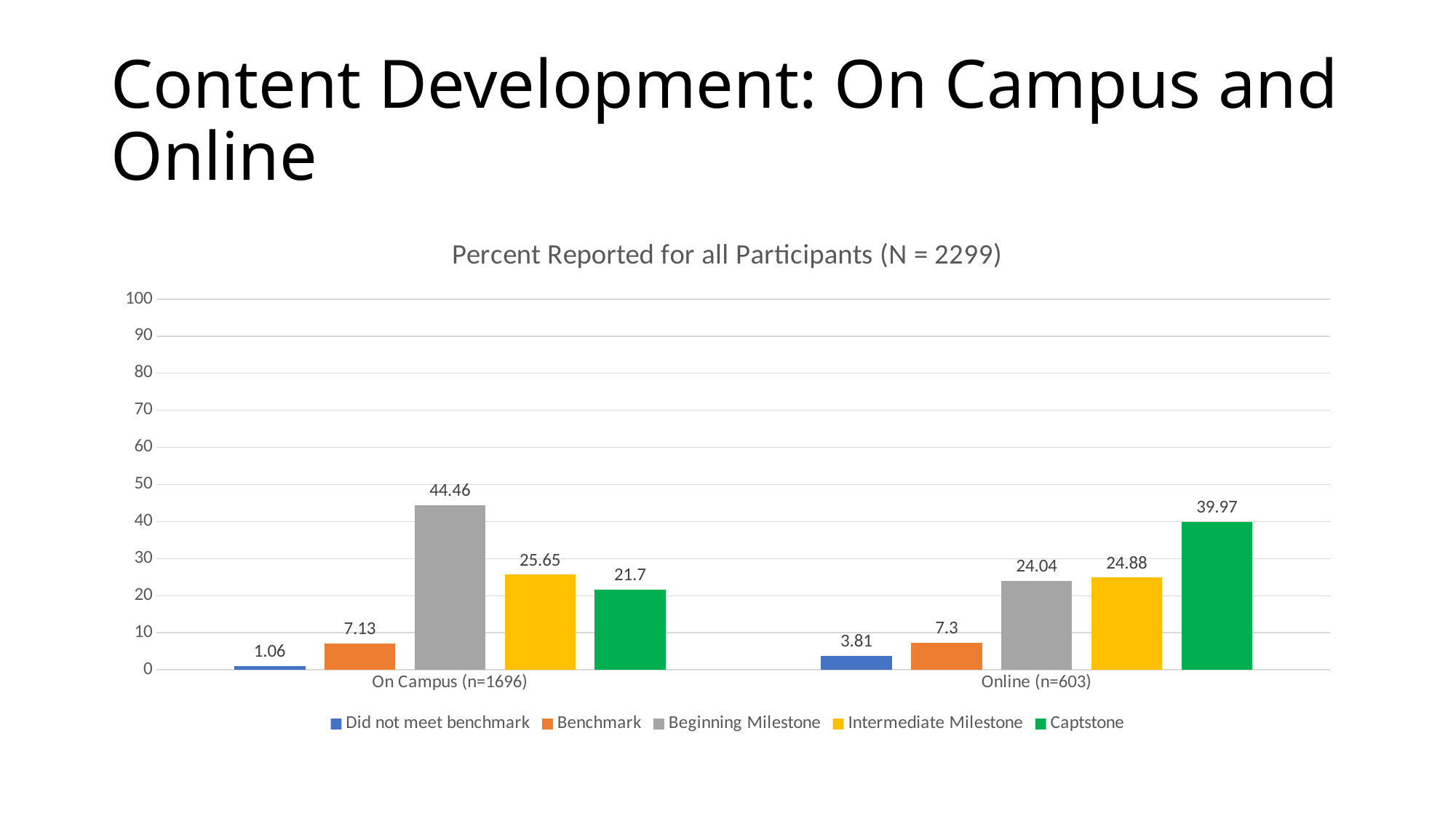
Is the Intermediate Milestone value for On Campus (n=1696) greater or less than 30? less Which is larger: the Captstone value for On Campus (n=1696) or for Online (n=603)? Online (n=603) What is the value for Did not meet benchmark in the Online (n=603) group? 3.81 Which series has the highest value in the On Campus (n=1696) group? Beginning Milestone What is the value for Captstone in the Online (n=603) group? 39.97 How many categories are shown on the x axis? 2 What is the difference between the Beginning Milestone values for On Campus (n=1696) and Online (n=603)? 20.42 What is the title of the chart? Percent Reported for all Participants (N = 2299) What is the value for Beginning Milestone in the On Campus (n=1696) group? 44.46 How many series does the legend list? 5 Which series has the lowest value in the Online (n=603) group? Did not meet benchmark What kind of chart is shown on the slide? Bar chart